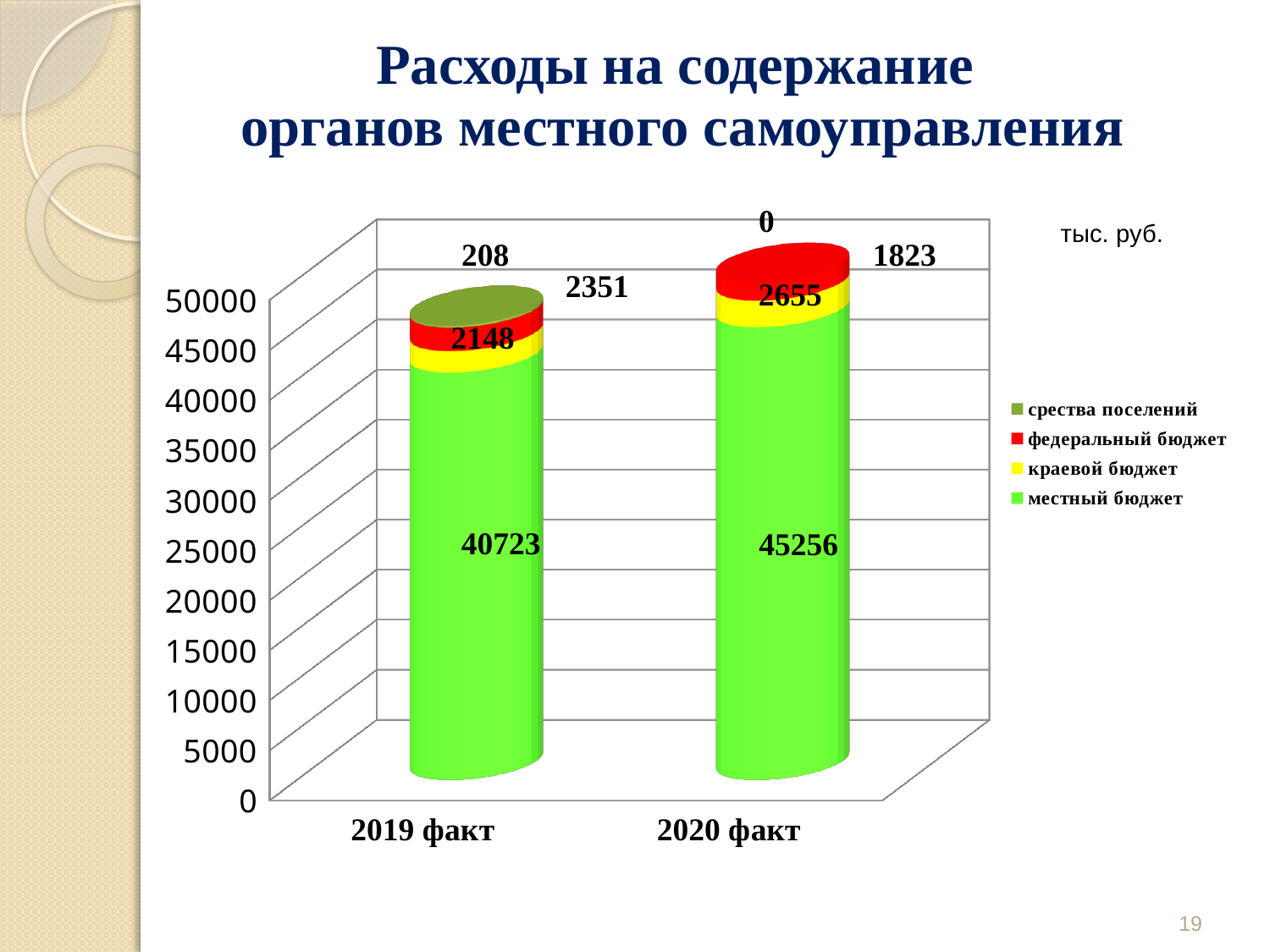
How many series does the legend list? 4 What is the total of the stacked bar for 2020 факт? 49734 Which year has the larger value for федеральный бюджет, 2019 факт or 2020 факт? 2019 факт What is the value of срества поселений for 2020 факт? 0 What kind of chart is shown on the slide? Stacked bar chart What is the value of краевой бюджет for 2020 факт? 2655 What is the difference between местный бюджет in 2020 факт and 2019 факт? 4533 What is the value of местный бюджет for 2020 факт? 45256 How many categories are shown on the x axis? 2 What is the total of the stacked bar for 2019 факт? 45430 What is the value of федеральный бюджет for 2019 факт? 2351 What is the value of местный бюджет for 2019 факт? 40723